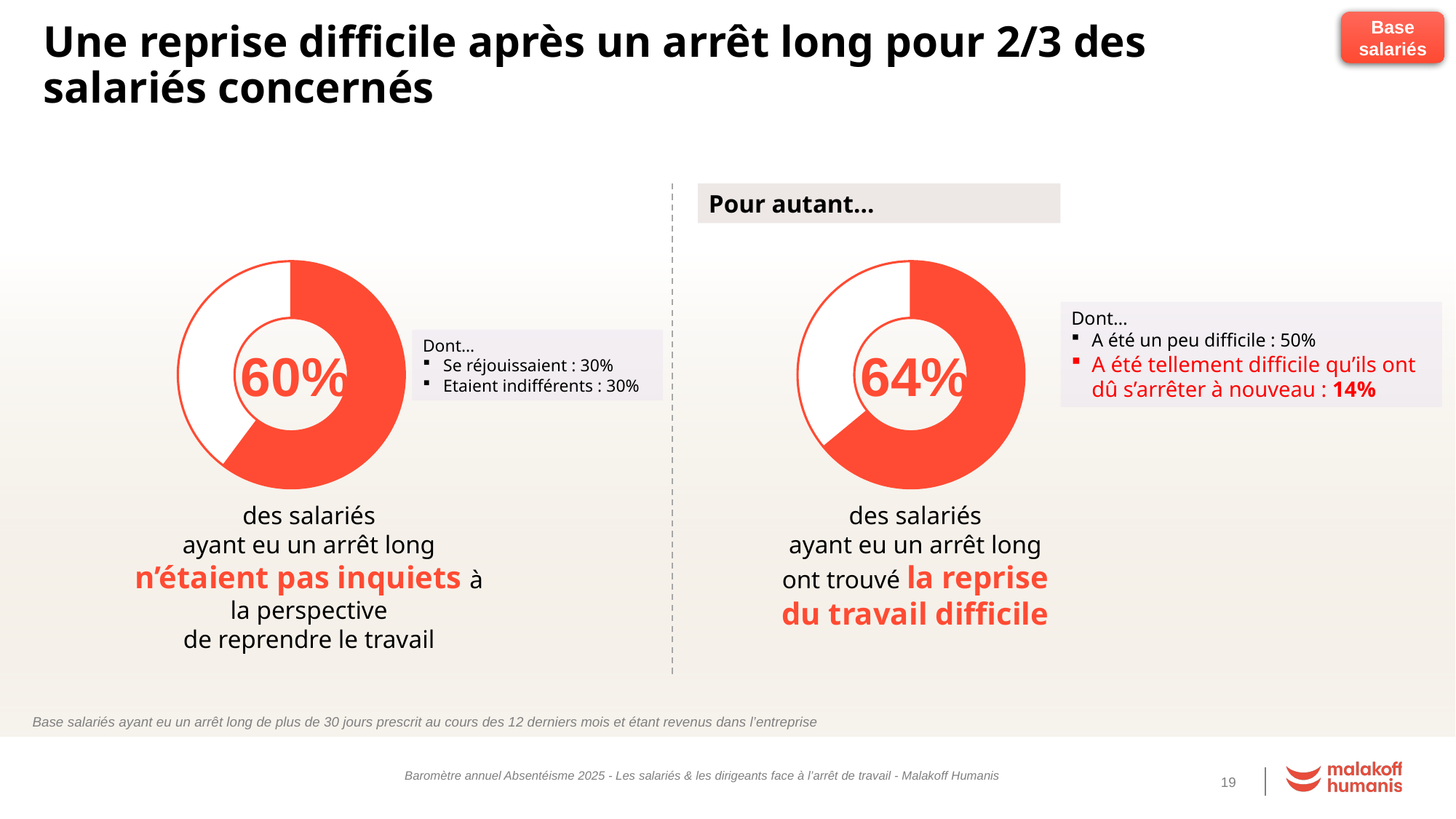
What kind of chart is used on the left side of the slide? Donut (pie) chart What percentage is shown in the centre of the left donut chart? 60% What percentage is shown in the centre of the right donut chart, under "Pour autant…"? 64% How many donut charts are shown on the slide? 2 In the left chart, what share of the donut is filled in red? 60% What is the heading shown above the right-hand chart? Pour autant… According to the text next to the left chart, what percentage of employees "se réjouissaient" (were glad) about returning to work? 30% Which chart shows the larger highlighted share, the left chart (60%) or the right chart (64%)? The right chart (64%) What is the difference in percentage points between the right chart's value (64%) and the left chart's value (60%)? 4 percentage points In the right chart, what share of the donut is left white (not red)? 36% According to the text next to the right chart, what percentage found the return so difficult that they had to stop working again? 14% According to the text next to the right chart, what percentage found the return "un peu difficile"? 50%